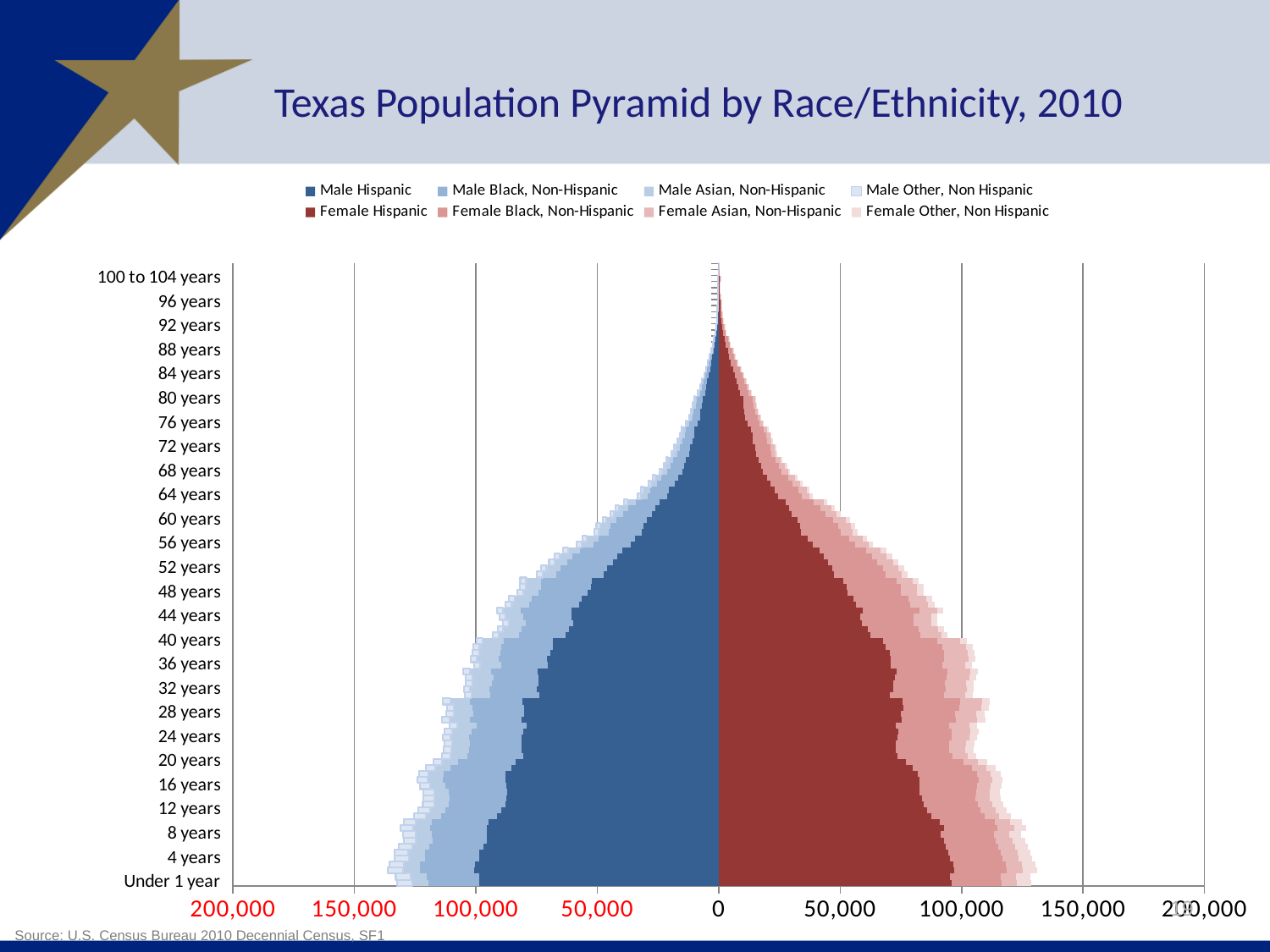
Do the bars generally get longer or shorter as age increases from Under 1 year to 100 to 104 years? Shorter Is the total female population at 80 years greater or less than 50,000? less Which legend entry is shown in the darkest blue colour? Male Hispanic Is the total female population for Under 1 year greater or less than 100,000? greater How many age labels are shown on the vertical axis? 26 Is the total male population at 60 years greater or less than 100,000? less At 80 years, which side of the pyramid is larger, male or female? Female How many series does the legend list? 8 What kind of chart is shown on the slide? Bar chart (population pyramid) What is the title of the chart? Texas Population Pyramid by Race/Ethnicity, 2010